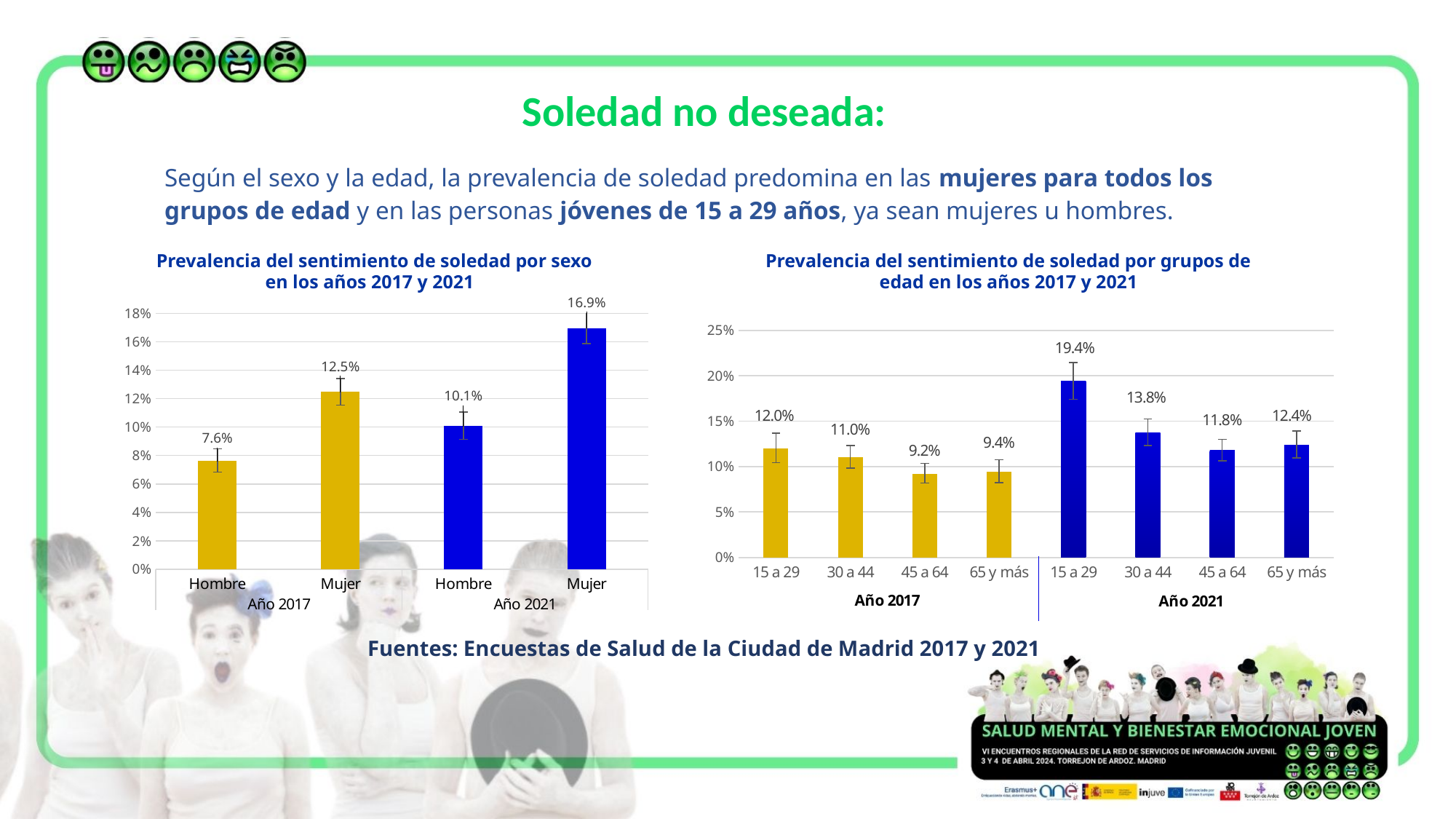
In the chart 'Prevalencia del sentimiento de soledad por grupos de edad en los años 2017 y 2021', what is the difference between 15 a 29 in Año 2021 and 15 a 29 in Año 2017? 7.4% In the chart 'Prevalencia del sentimiento de soledad por sexo en los años 2017 y 2021', what is the difference between Mujer and Hombre in Año 2021? 6.8% In the chart 'Prevalencia del sentimiento de soledad por grupos de edad en los años 2017 y 2021', which age group has the highest value in Año 2021? 15 a 29 In the chart 'Prevalencia del sentimiento de soledad por grupos de edad en los años 2017 y 2021', what is the value for 45 a 64 in Año 2017? 9.2% In the chart 'Prevalencia del sentimiento de soledad por grupos de edad en los años 2017 y 2021', how many bars are plotted in total? 8 In the chart 'Prevalencia del sentimiento de soledad por sexo en los años 2017 y 2021', how many bars are plotted? 4 What kind of chart is 'Prevalencia del sentimiento de soledad por grupos de edad en los años 2017 y 2021'? Bar chart In the chart 'Prevalencia del sentimiento de soledad por grupos de edad en los años 2017 y 2021', what is the value for 15 a 29 in Año 2021? 19.4% In the chart 'Prevalencia del sentimiento de soledad por sexo en los años 2017 y 2021', what is the value for Mujer in Año 2021? 16.9% In the chart 'Prevalencia del sentimiento de soledad por sexo en los años 2017 y 2021', what is the value for Hombre in Año 2017? 7.6% In the chart 'Prevalencia del sentimiento de soledad por sexo en los años 2017 y 2021', which bar has the lowest value? Hombre, Año 2017 In the chart 'Prevalencia del sentimiento de soledad por grupos de edad en los años 2017 y 2021', which is larger: 30 a 44 in Año 2017 or 30 a 44 in Año 2021? 30 a 44 in Año 2021